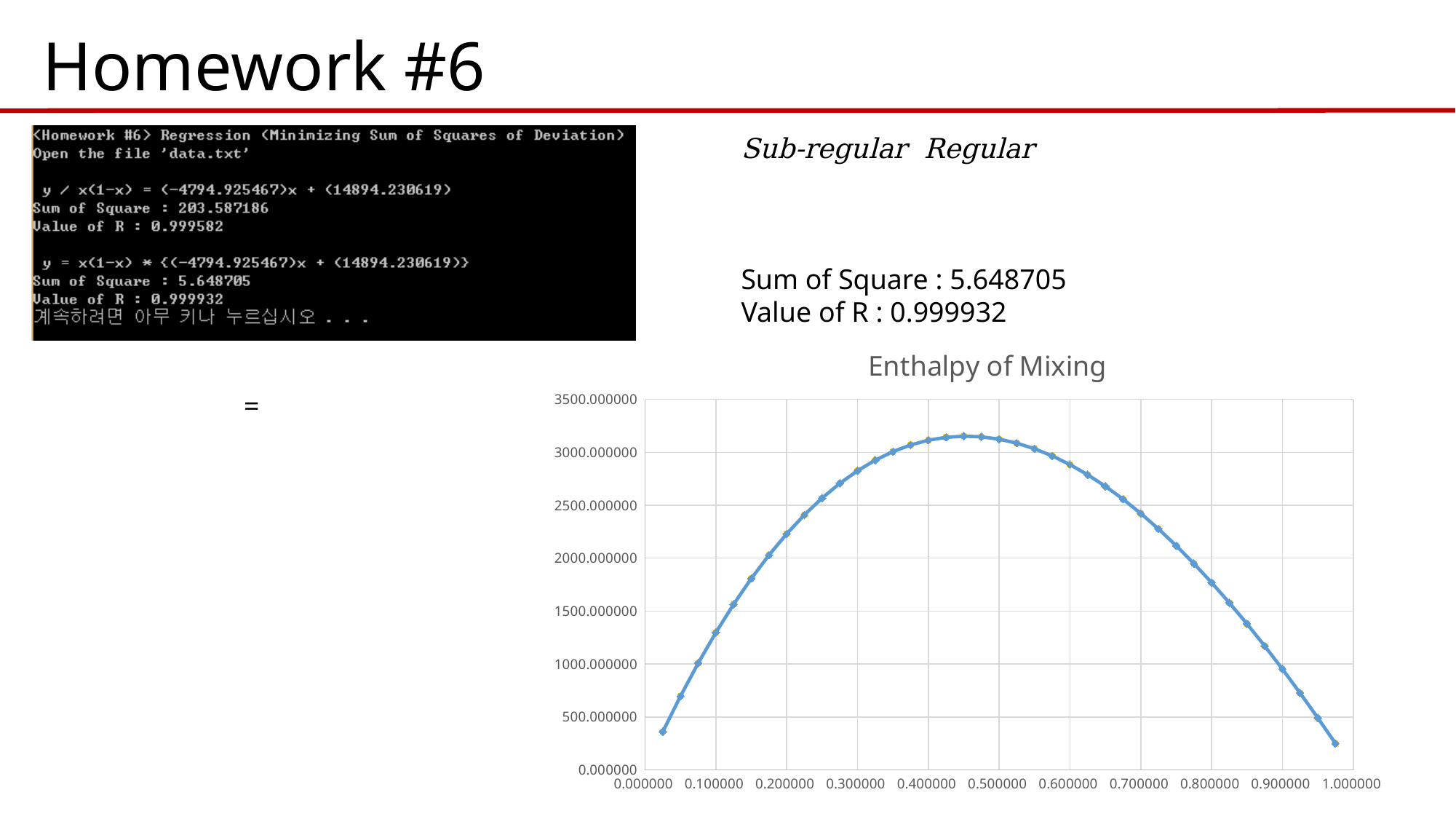
In the Enthalpy of Mixing chart, is the value at x = 0.500000 greater or less than 3000? greater In the Enthalpy of Mixing chart, is the value at x = 0.950000 greater or less than 1000? less What kind of chart is the Enthalpy of Mixing chart? line chart In the Enthalpy of Mixing chart, is the highest point of the curve greater or less than 3500? less In the Enthalpy of Mixing chart, which is larger: the value at x = 0.300000 or the value at x = 0.800000? the value at x = 0.300000 What is the title of the chart on the slide? Enthalpy of Mixing In the Enthalpy of Mixing chart, do the values rise or fall as x increases from 0.600000 to 1.000000? fall In the Enthalpy of Mixing chart, do the values rise or fall as x increases from 0.000000 to 0.400000? rise What is the highest tick label shown on the y axis of the Enthalpy of Mixing chart? 3500.000000